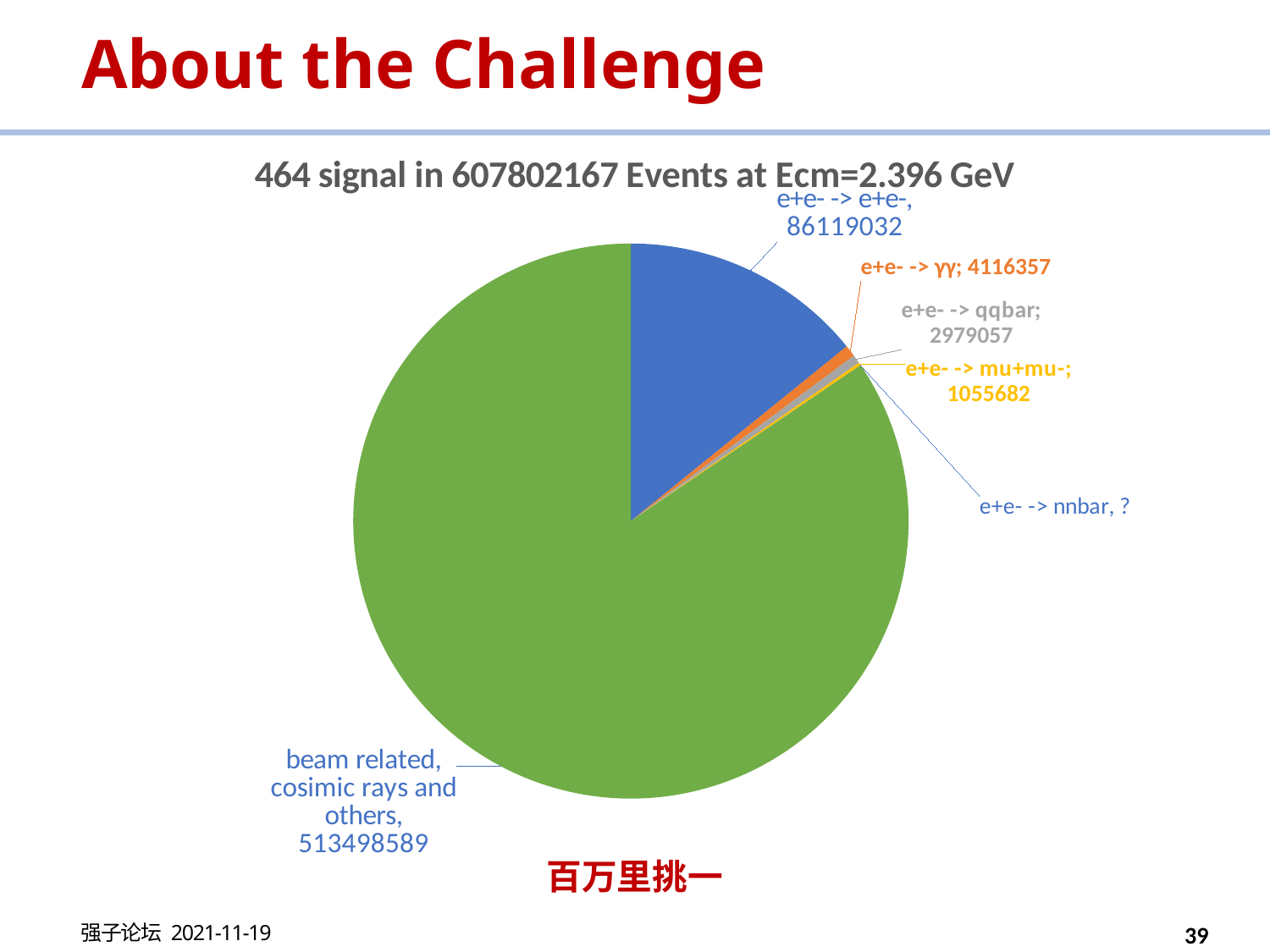
What is the difference between the 'e+e- -> γγ' value and the 'e+e- -> qqbar' value? 1137300 Among the slices with a numeric label, which has the smallest value? e+e- -> mu+mu- What is the title of the pie chart? 464 signal in 607802167 Events at Ecm=2.396 GeV What is the value for the 'e+e- -> γγ' slice? 4116357 Which is larger, the 'e+e- -> γγ' slice or the 'e+e- -> qqbar' slice? e+e- -> γγ How many slices are labelled in the pie chart? 6 What is the value for the 'e+e- -> e+e-' slice? 86119032 What is the value for the 'e+e- -> mu+mu-' slice? 1055682 Which slice is the largest in the pie chart? beam related, cosimic rays and others What is the value for the 'e+e- -> qqbar' slice? 2979057 What kind of chart is shown on the slide? pie chart What is the value for the 'beam related, cosimic rays and others' slice? 513498589